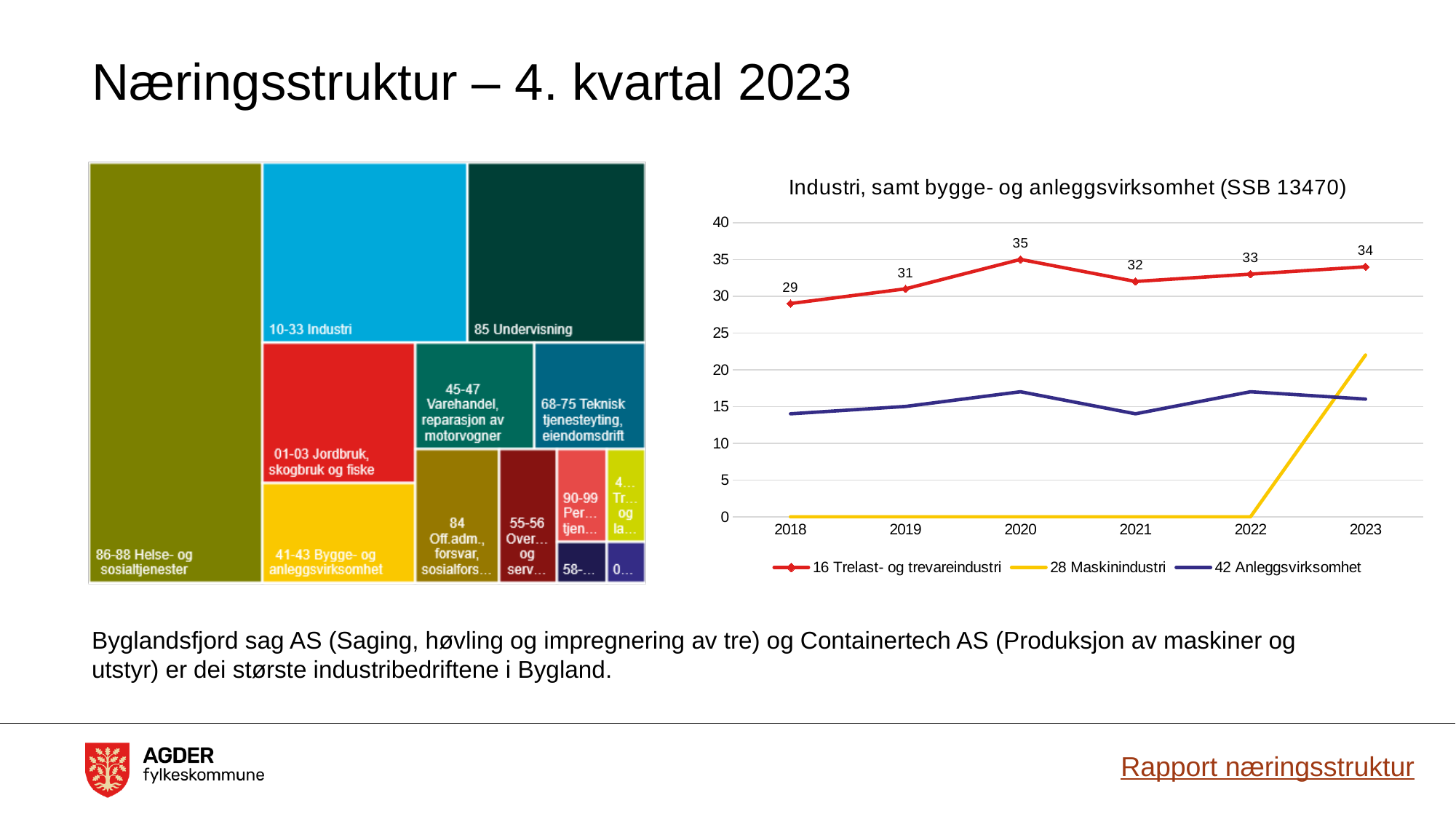
In the line chart 'Industri, samt bygge- og anleggsvirksomhet (SSB 13470)', what is the value for 16 Trelast- og trevareindustri in 2020? 35 In the line chart on the right, which series has the higher value in 2023: 16 Trelast- og trevareindustri or 42 Anleggsvirksomhet? 16 Trelast- og trevareindustri In the chart on the left, which category occupies the largest area? 86-88 Helse- og sosialtjenester In the line chart on the right, in which year is 16 Trelast- og trevareindustri lowest? 2018 In the line chart on the right, in which year is 16 Trelast- og trevareindustri highest? 2020 In the line chart on the right, what is the difference between the 2020 and 2021 values for 16 Trelast- og trevareindustri? 3 In the line chart on the right, is the value for 28 Maskinindustri in 2023 greater or less than 20? greater In the line chart on the right, what is the value for 16 Trelast- og trevareindustri in 2023? 34 In the line chart on the right, what is the value for 16 Trelast- og trevareindustri in 2018? 29 How many years are shown on the x axis of the line chart on the right? 6 How many series does the legend of the line chart on the right list? 3 In the line chart on the right, is the value for 42 Anleggsvirksomhet in 2021 greater or less than 15? less